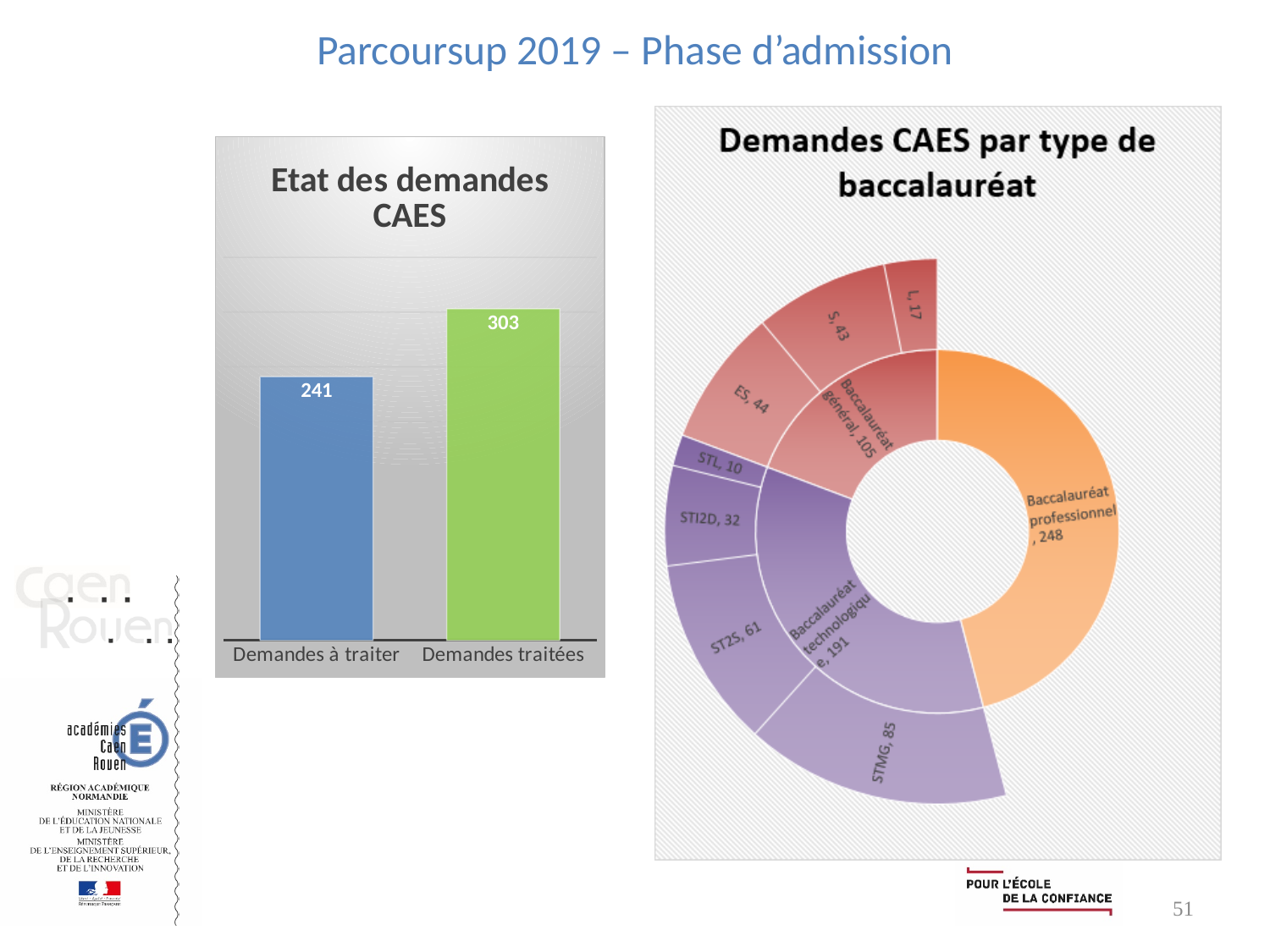
How many categories are shown in the 'Etat des demandes CAES' chart? 2 In the 'Demandes CAES par type de baccalauréat' chart, what is the value for 'Baccalauréat professionnel'? 248 In the 'Demandes CAES par type de baccalauréat' chart, what is the value for 'Baccalauréat technologique'? 191 What kind of chart is 'Etat des demandes CAES'? bar chart In the 'Demandes CAES par type de baccalauréat' chart, what is the value for 'STMG'? 85 In the 'Etat des demandes CAES' chart, what is the value for 'Demandes à traiter'? 241 In the 'Etat des demandes CAES' chart, what is the value for 'Demandes traitées'? 303 In the 'Etat des demandes CAES' chart, which category has the higher value? Demandes traitées In the 'Etat des demandes CAES' chart, what is the difference between 'Demandes traitées' and 'Demandes à traiter'? 62 In the 'Demandes CAES par type de baccalauréat' chart, what is the difference between 'ES' and 'S'? 1 In the 'Demandes CAES par type de baccalauréat' chart, which type of baccalauréat has the highest value? Baccalauréat professionnel In the 'Demandes CAES par type de baccalauréat' chart, which of the outer-ring categories has the lowest value? STL